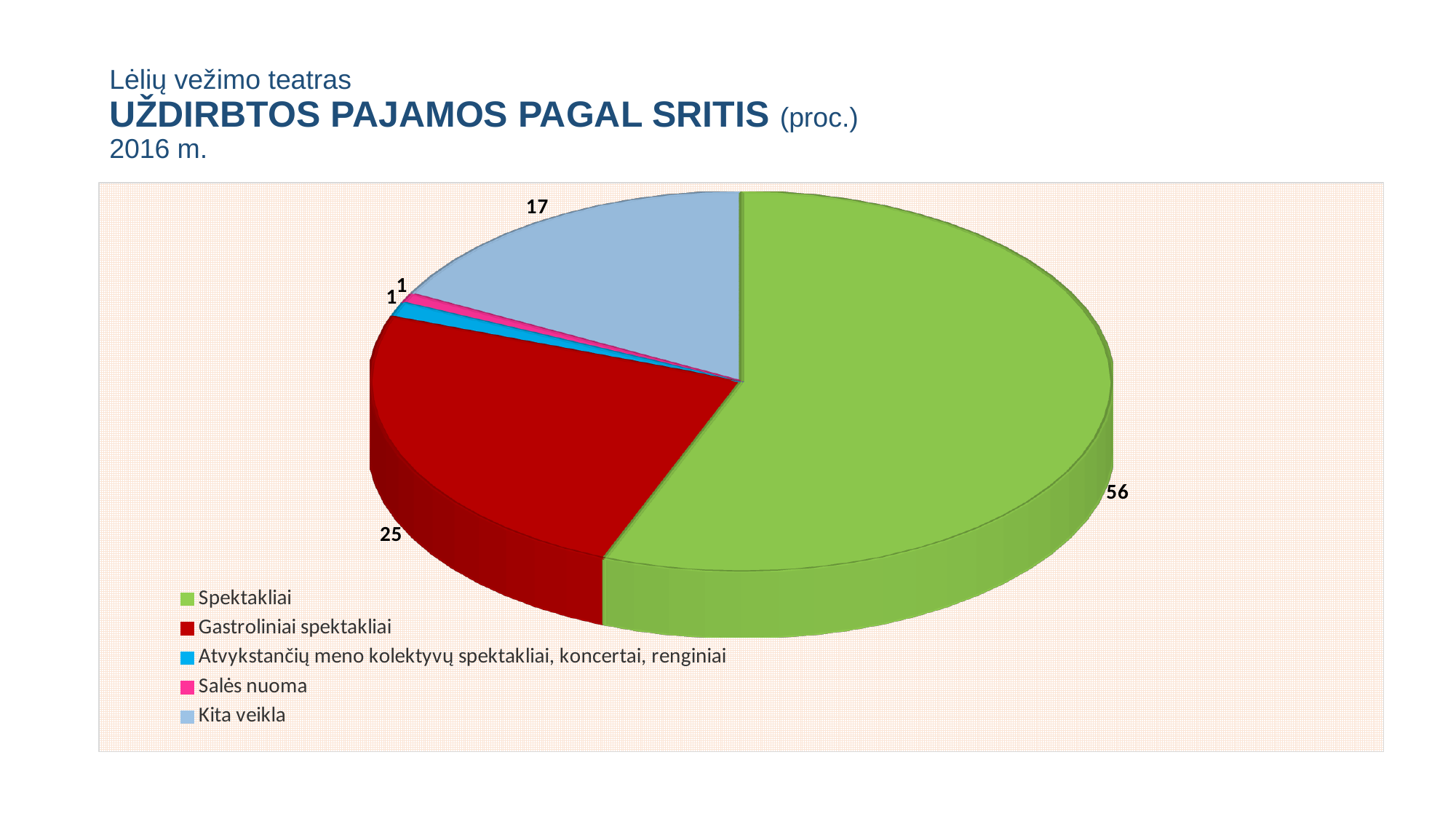
What is the value for Gastroliniai spektakliai? 25 What is the value for Salės nuoma? 1 What is the difference between the values for Kita veikla and Salės nuoma? 16 Which category has the largest share of the pie? Spektakliai What type of chart is shown on the slide? pie chart What is the value for Spektakliai? 56 What colour is the Gastroliniai spektakliai slice? red Which is larger, Gastroliniai spektakliai or Kita veikla? Gastroliniai spektakliai Which year does the chart refer to? 2016 m. How many categories does the legend list? 5 What is the difference between the values for Spektakliai and Gastroliniai spektakliai? 31 What is the value for Kita veikla? 17